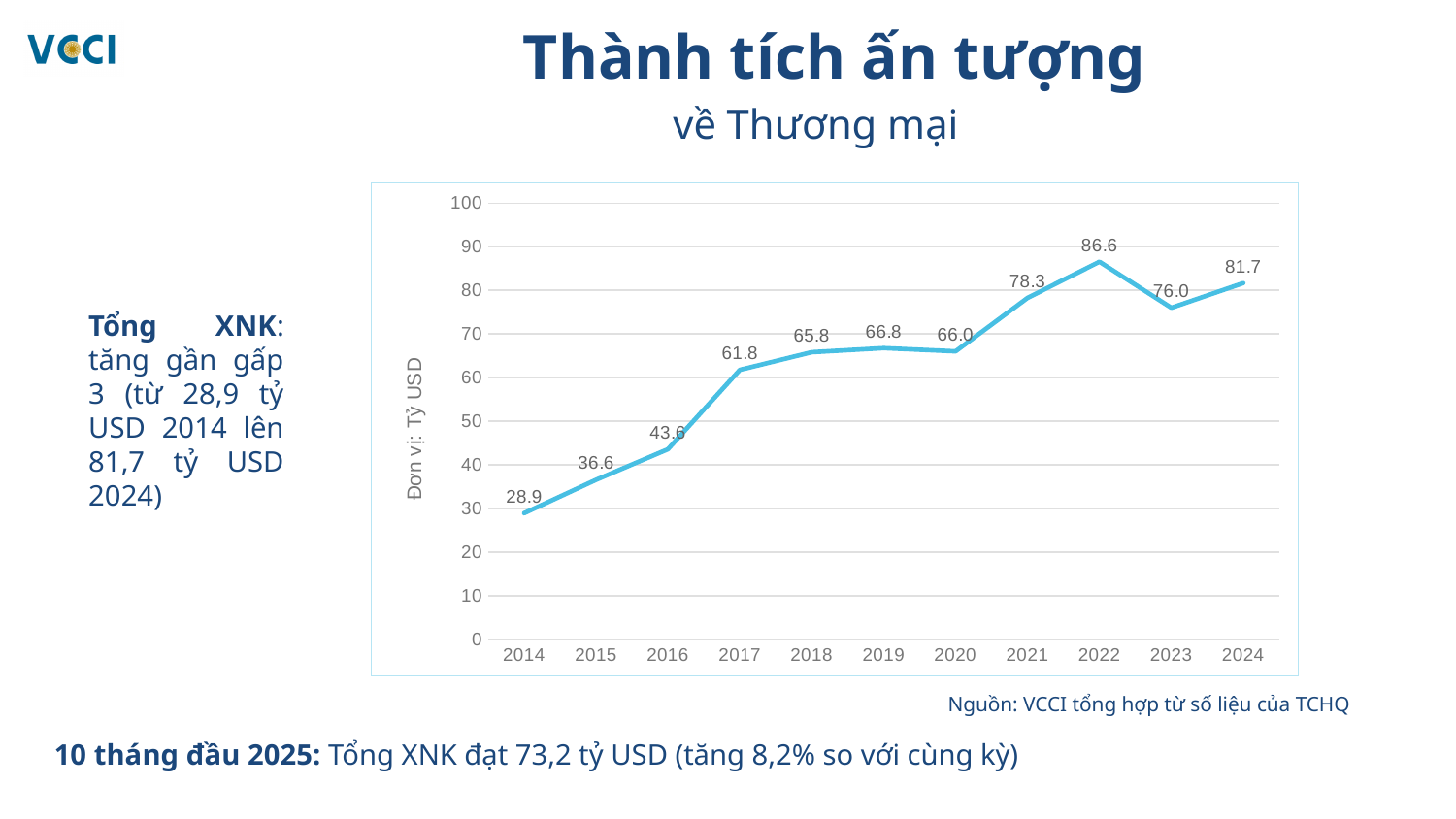
Is the value for 2021 greater or less than 70? greater What is the difference between the values for 2024 and 2014? 52.8 What is the value for 2014? 28.9 What is the value for 2022? 86.6 What is the value for 2020? 66.0 What is the unit shown on the vertical axis label? Tỷ USD Which year has the lowest value? 2014 What kind of chart is shown on the slide? line chart Which is larger, the value for 2017 or the value for 2016? 2017 Which year has the highest value? 2022 How many years are plotted on the x axis? 11 What is the difference between the values for 2022 and 2023? 10.6